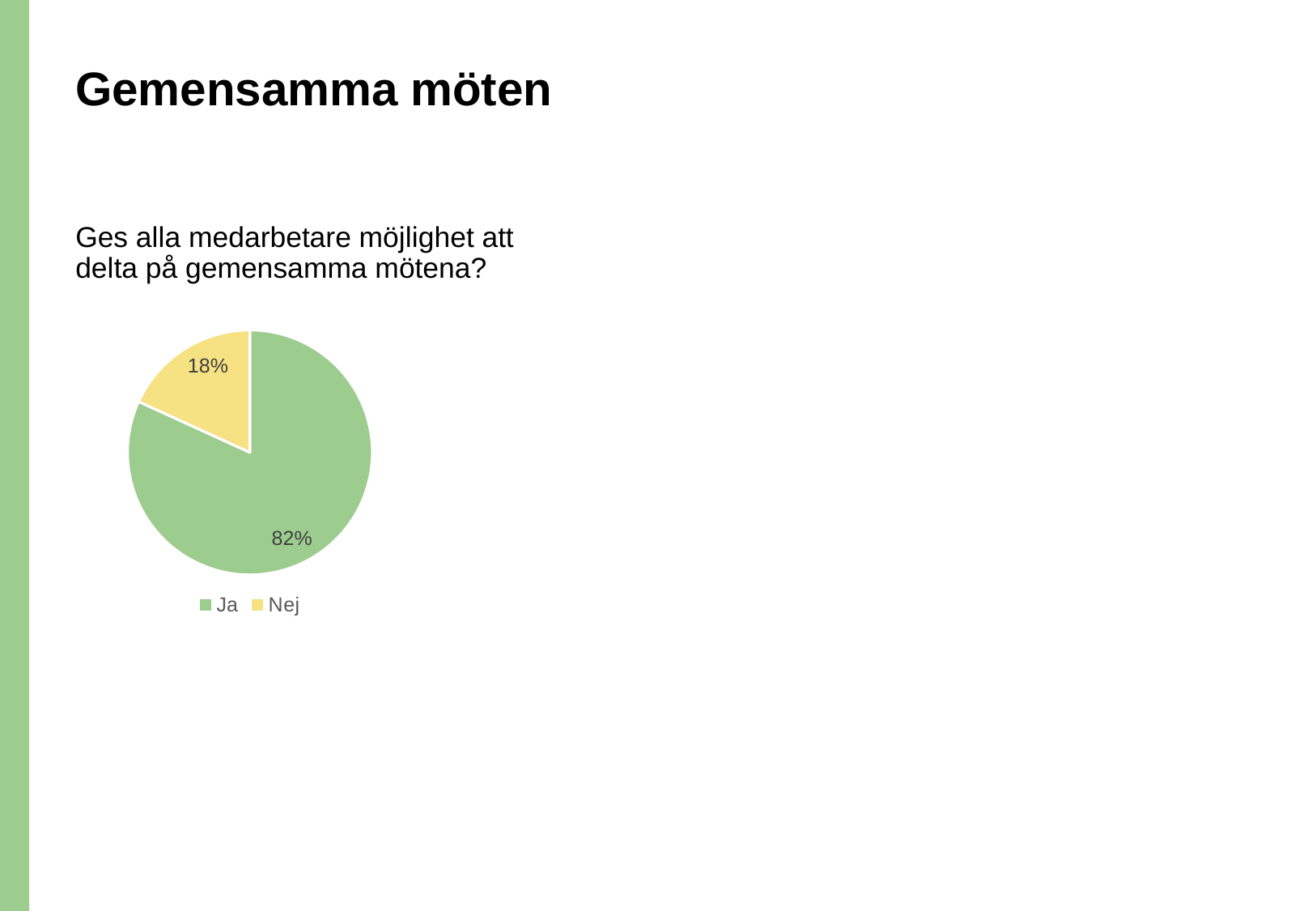
What is the difference in percentage points between the "Ja" and "Nej" slices? 64 Which is larger, the "Ja" slice or the "Nej" slice? Ja How many entries does the legend list? 2 What share of the pie does "Nej" represent? 18% What colour is the "Nej" slice? yellow Which category has the largest slice of the pie? Ja What share of the pie does "Ja" represent? 82% What question is the pie chart answering, as written above it? Ges alla medarbetare möjlighet att delta på gemensamma mötena? How many slices does the pie chart have? 2 What kind of chart is shown on the slide? pie chart Which category has the smallest slice of the pie? Nej